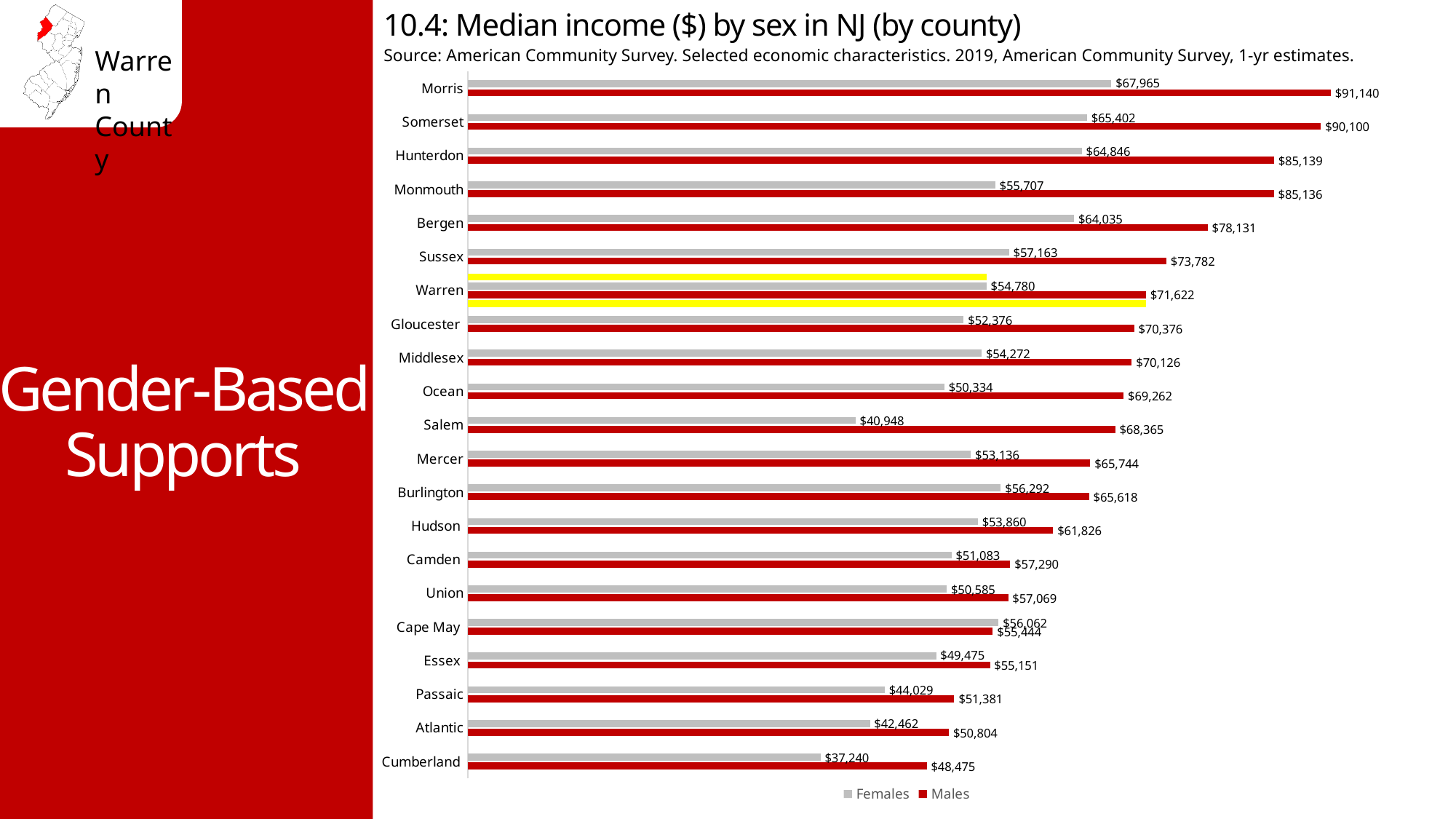
What is the median income for males in Warren County? $71,622 What is the difference between the male and female median incomes in Morris County? $23,175 Which county has the highest median income for males? Morris What is the median income for females in Warren County? $54,780 Which county has the lowest median income for females? Cumberland What is the median income for males in Monmouth County? $85,136 What is the difference between the male and female median incomes in Warren County? $16,842 In Cape May County, is the median income higher for females or for males? Females How many series does the legend list? 2 What type of chart is shown on the slide? Bar chart Which colour represents Males in the chart? Red How many counties are shown in the chart? 21